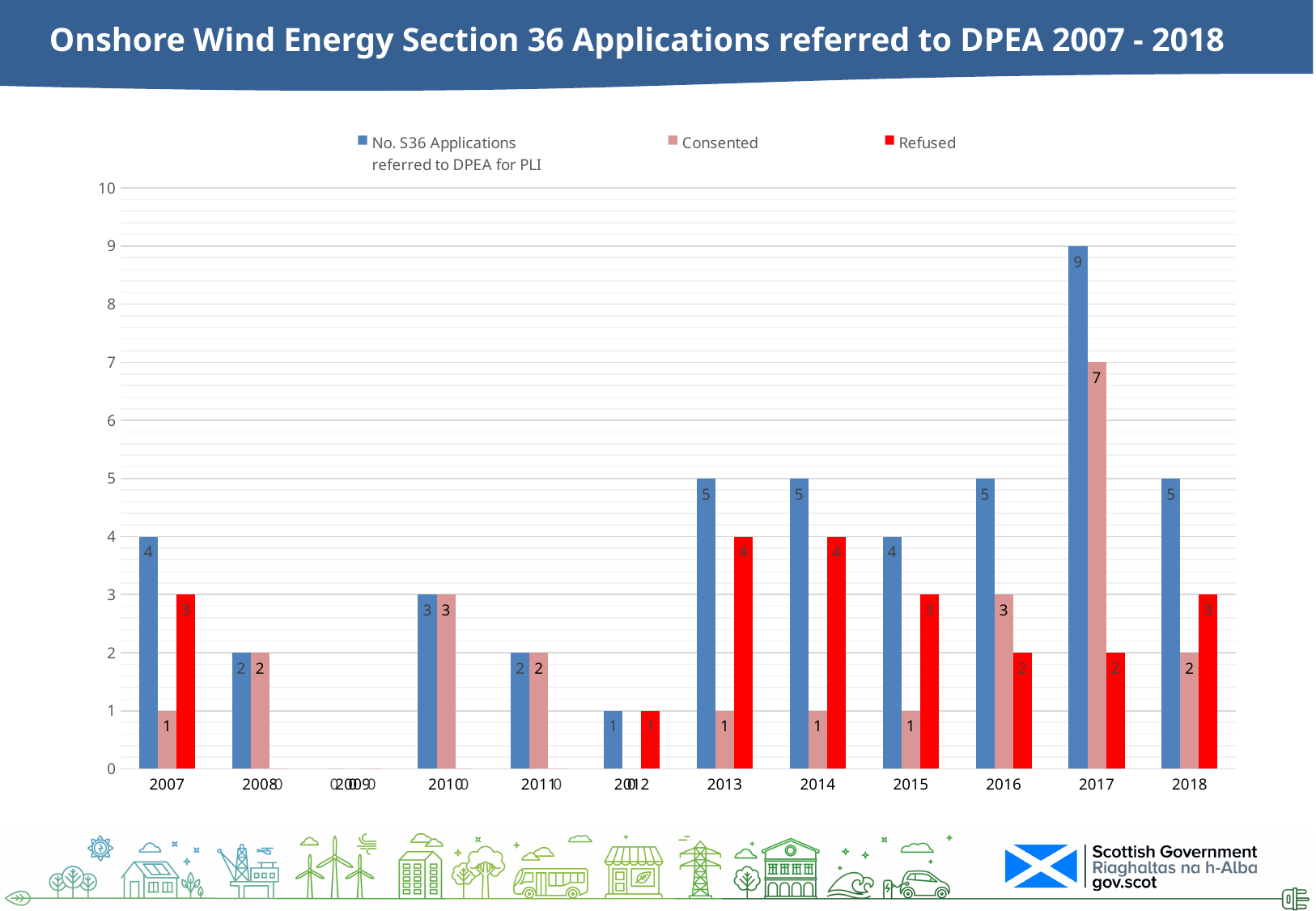
What is the difference between the number of applications refused in 2007 and in 2016? 1 What type of chart is shown on the slide? bar chart How many series does the legend list? 3 What is the number of S36 applications referred to DPEA for PLI in 2017? 9 How many applications were consented in 2017? 7 Which year has the highest number of S36 applications referred to DPEA for PLI? 2017 Which is larger in 2014: the number consented or the number refused? Refused Which colour represents the Refused series in the chart? red What is the difference between the number of applications referred and the number consented in 2017? 2 How many applications were refused in 2013? 4 How many years are shown on the x axis? 12 How many applications were consented in 2016? 3